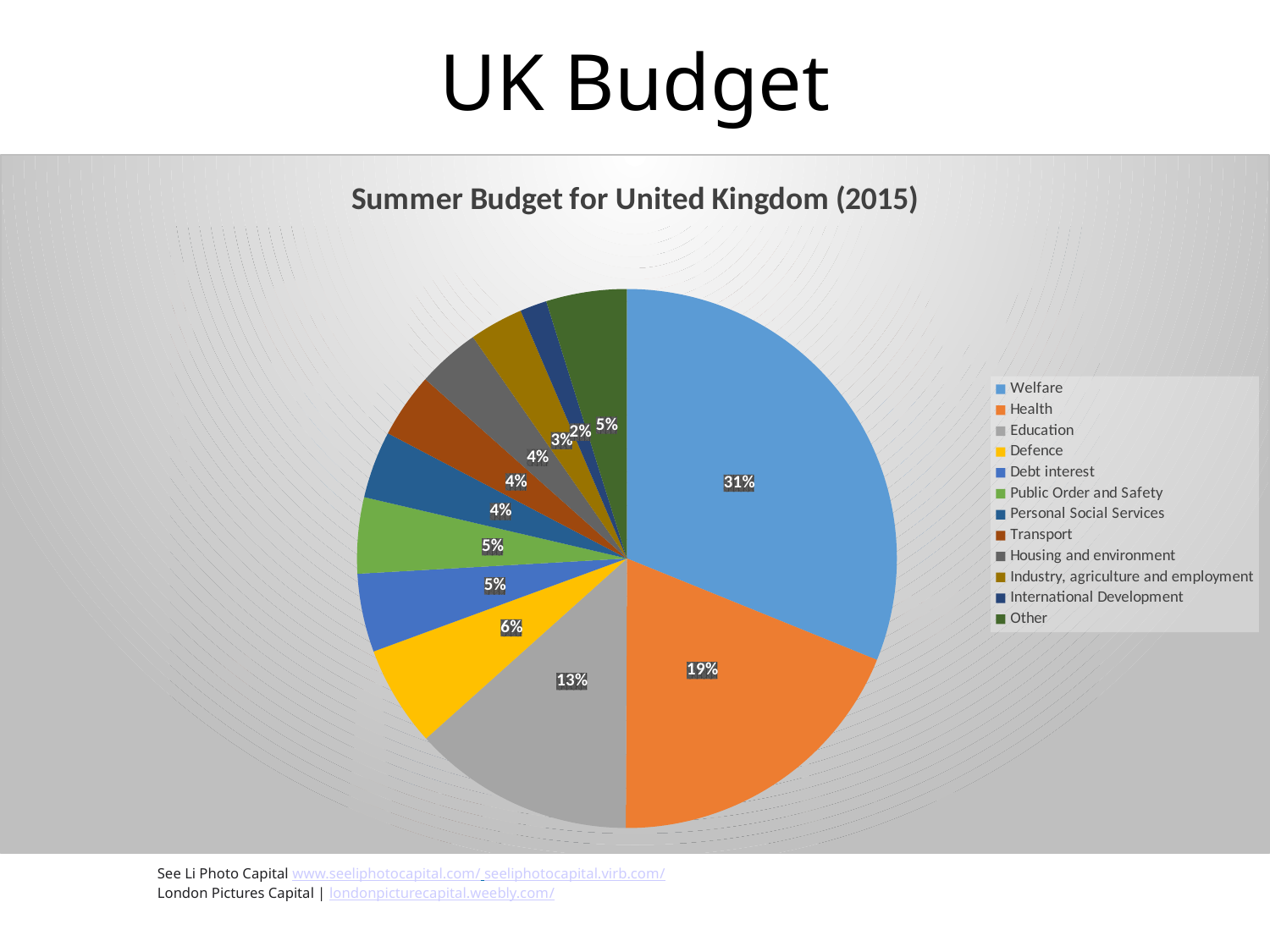
Which has a larger share, Education or Defence? Education What is the chart title? Summer Budget for United Kingdom (2015) What share of the budget goes to International Development? 2% What share of the budget goes to Welfare? 31% What is the difference in percentage points between the Welfare and Health shares? 12 What share of the budget goes to Defence? 6% Which category has the smallest share of the budget? International Development How many categories does the legend list? 12 What type of chart is shown on the slide? Pie chart What share of the budget goes to Education? 13% What share of the budget goes to Health? 19% Which category has the largest share of the budget? Welfare